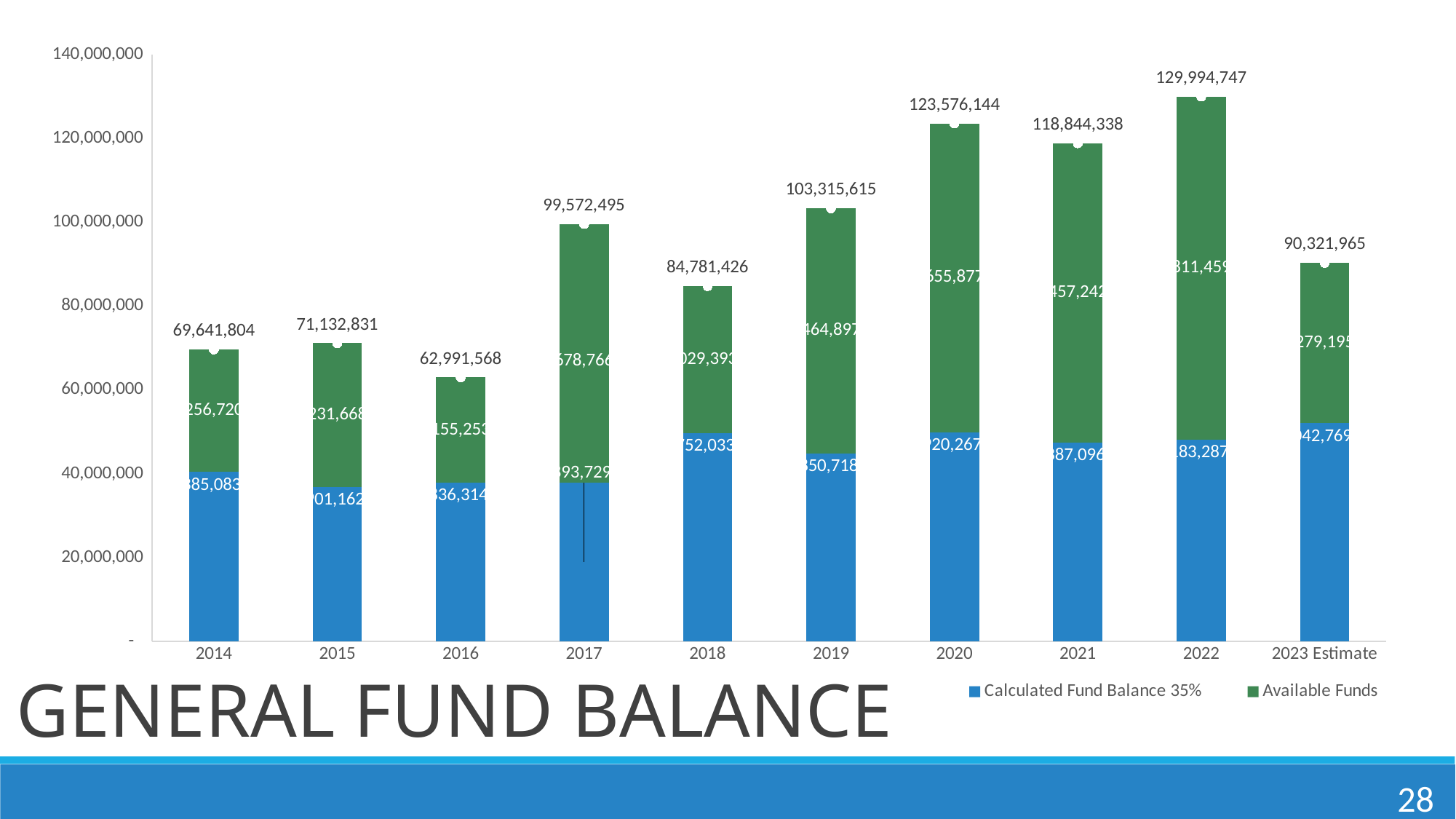
What is the total value shown above the bar for 2022? 129,994,747 Is the Calculated Fund Balance 35% value for 2014 greater or less than 60,000,000? less What is the difference between the total for 2020 and the total for 2021? 4,731,806 Which year has the lowest total bar? 2016 What is the total value shown above the bar for 2016? 62,991,568 What kind of chart is shown on the slide? Stacked bar chart Which year has the highest total bar? 2022 Do the total values rise or fall from 2021 to 2022? Rise Which total is larger, 2017 or 2018? 2017 How many series does the legend list? 2 What is the total value shown above the bar for 2023 Estimate? 90,321,965 How many years (categories) are shown on the x axis? 10